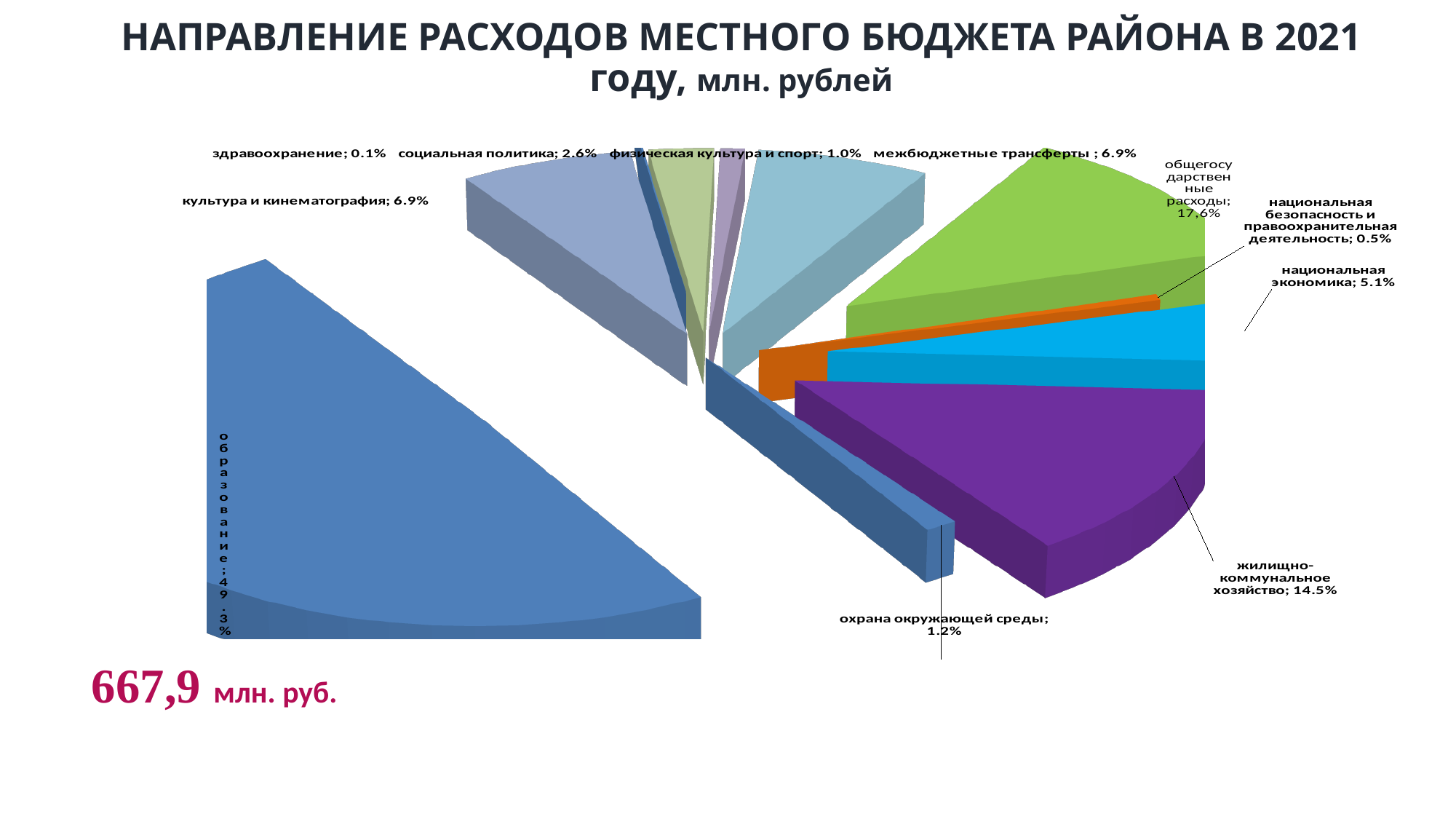
What share is shown for общегосударственные расходы? 17,6% What share is shown for национальная экономика? 5.1% What share of the budget goes to образование? 49.3% Which category has the smallest share of the pie? здравоохранение What is the difference in percentage points between общегосударственные расходы and жилищно-коммунальное хозяйство? 3.1 How many categories are shown in the pie chart? 11 What kind of chart is shown on the slide? pie chart Which category has the largest share of the pie? образование Which is larger: the share for социальная политика or the share for физическая культура и спорт? социальная политика What share is shown for охрана окружающей среды? 1.2% What total amount in млн. руб. is printed on the slide below the chart? 667,9 What share is shown for жилищно-коммунальное хозяйство? 14.5%